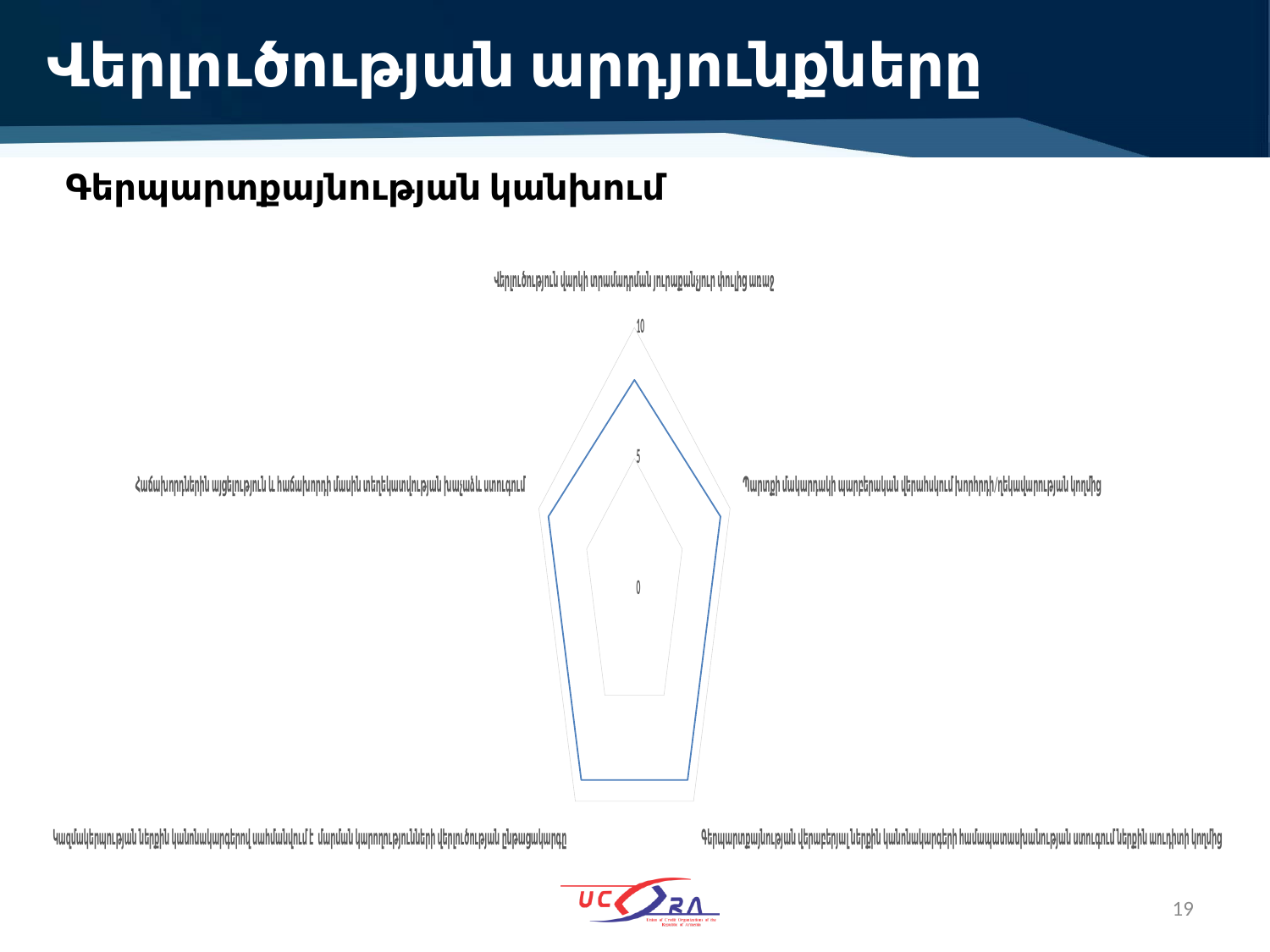
Is the value on the top axis (Վերլուծություն վարկի տրամադրման յուրաքանչյուր փուլից առաջ) greater or less than 5? greater Is the value on the bottom-left axis (Կազմակերպության ներքին կանոնակարգերով սահմանվում է մարման կարողությունների վերլուծության ընթացակարգը) greater or less than 5? greater What is the highest value marked on the radar chart's axis scale? 10 What colour is the data line plotted on the radar chart? blue Is the value on the top axis of the radar chart greater or less than 10? less How many categories (axes) does the radar chart have? 5 What kind of chart is shown on the slide? radar chart